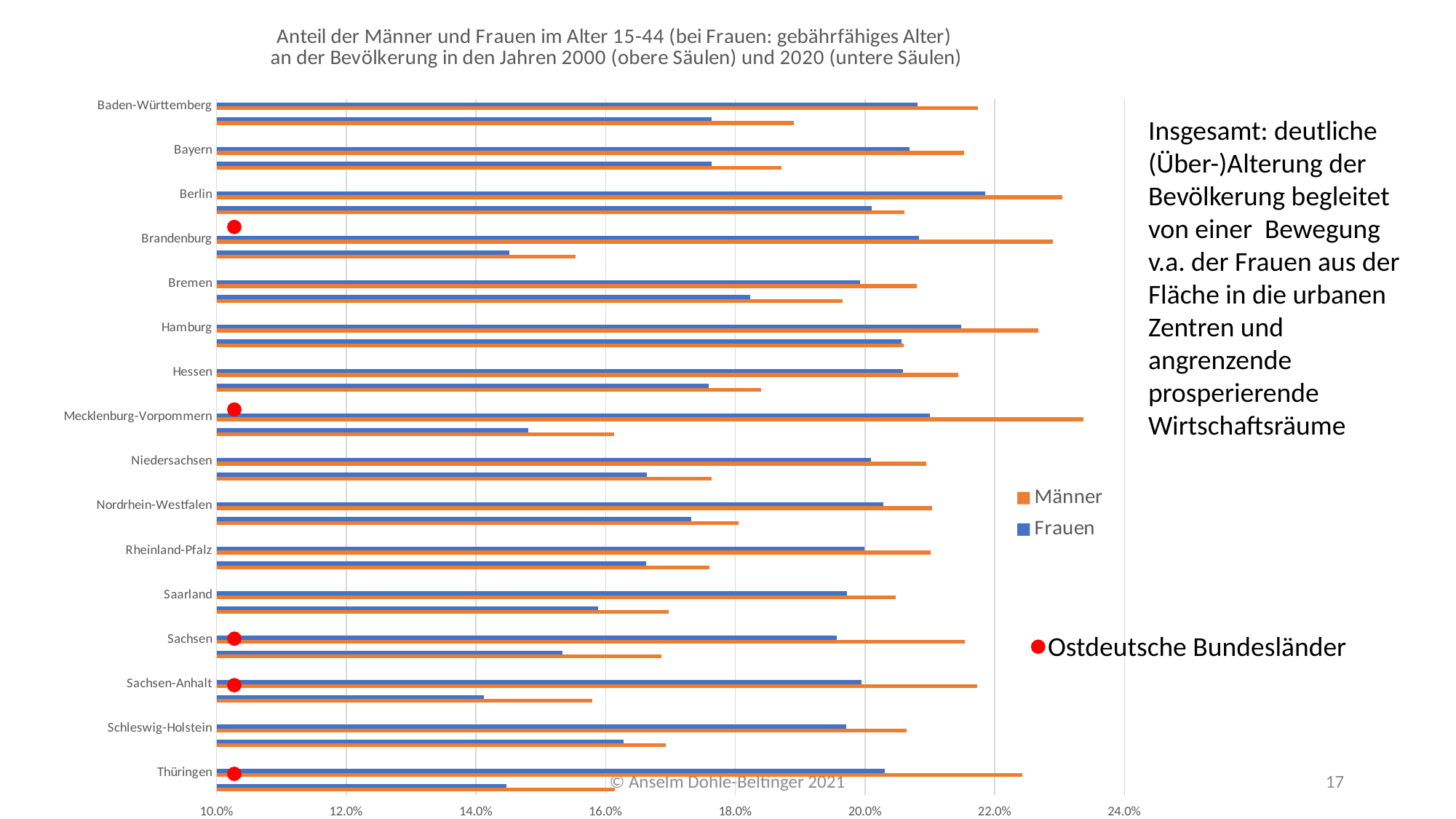
Is the 2020 (lower) Männer bar for Saarland greater or less than 18.0%? less How many German states (categories) are listed on the vertical axis of the chart? 16 Which is larger: the 2020 (lower) Männer bar for Berlin or the 2020 (lower) Männer bar for Sachsen? Berlin Is the 2020 (lower) Frauen bar for Sachsen-Anhalt greater or less than 16.0%? less Is the 2000 (upper) Männer bar for Mecklenburg-Vorpommern greater or less than 22.0%? greater According to the legend, what do the red dots next to some state names mark? Ostdeutsche Bundesländer What kind of chart is shown on the slide? bar chart How many series does the chart legend list? 2 Which is larger: the 2020 (lower) Frauen bar for Hamburg or the 2020 (lower) Frauen bar for Brandenburg? Hamburg Which two series are named in the chart legend? Männer and Frauen